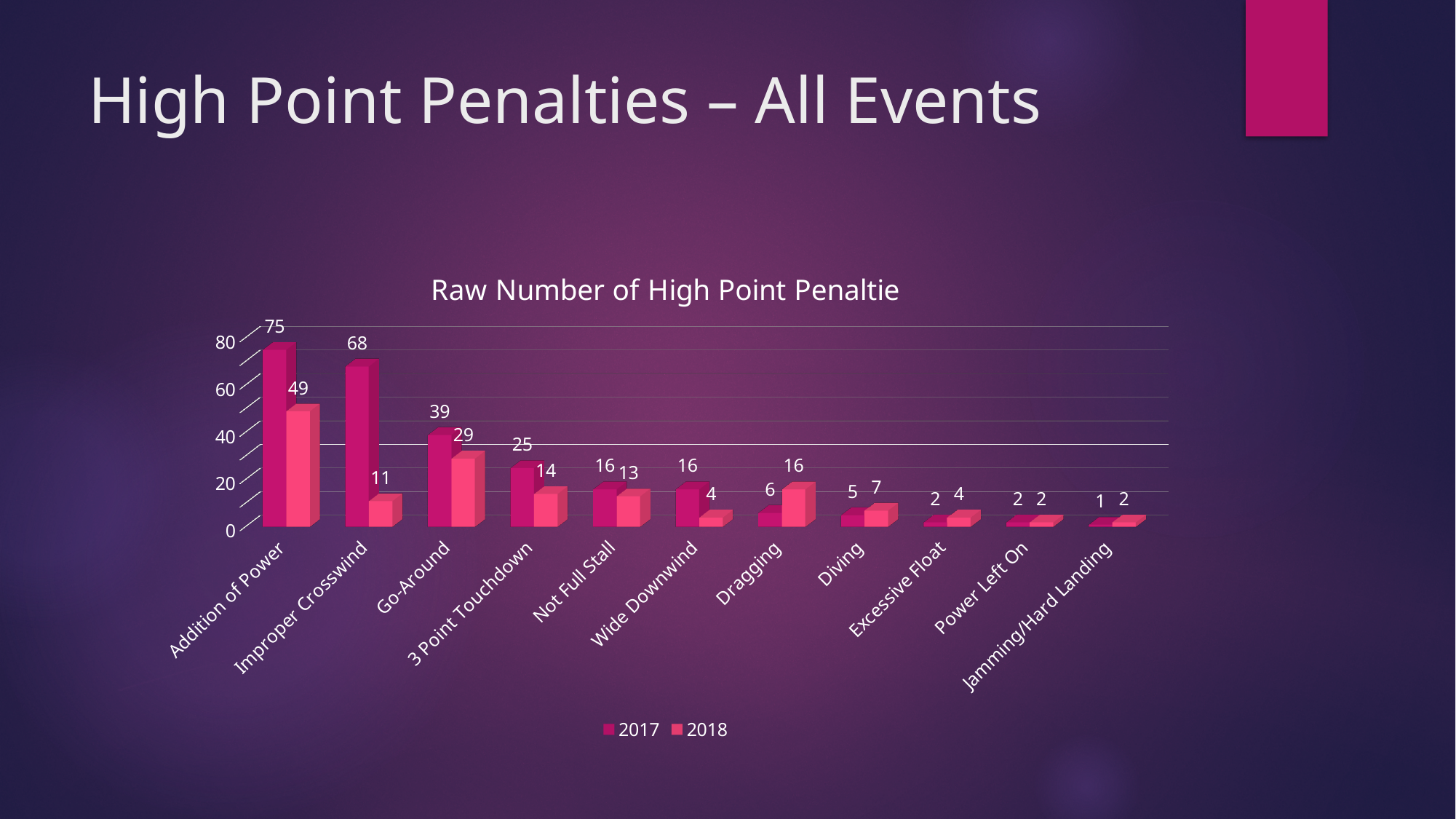
Which is larger for Dragging, the 2017 value or the 2018 value? 2018 What is the title of the chart? Raw Number of High Point Penaltie What is the 2017 value for Addition of Power? 75 How many series does the legend list? 2 Which category has the highest 2017 value? Addition of Power How many categories are shown on the x axis? 11 What is the 2018 value for Go-Around? 29 What is the 2018 value for Improper Crosswind? 11 What kind of chart is shown on the slide? Bar chart Which category has the lowest 2017 value? Jamming/Hard Landing What is the difference between the 2017 and 2018 values for Improper Crosswind? 57 Is the 2017 value for Go-Around greater or less than 20? greater